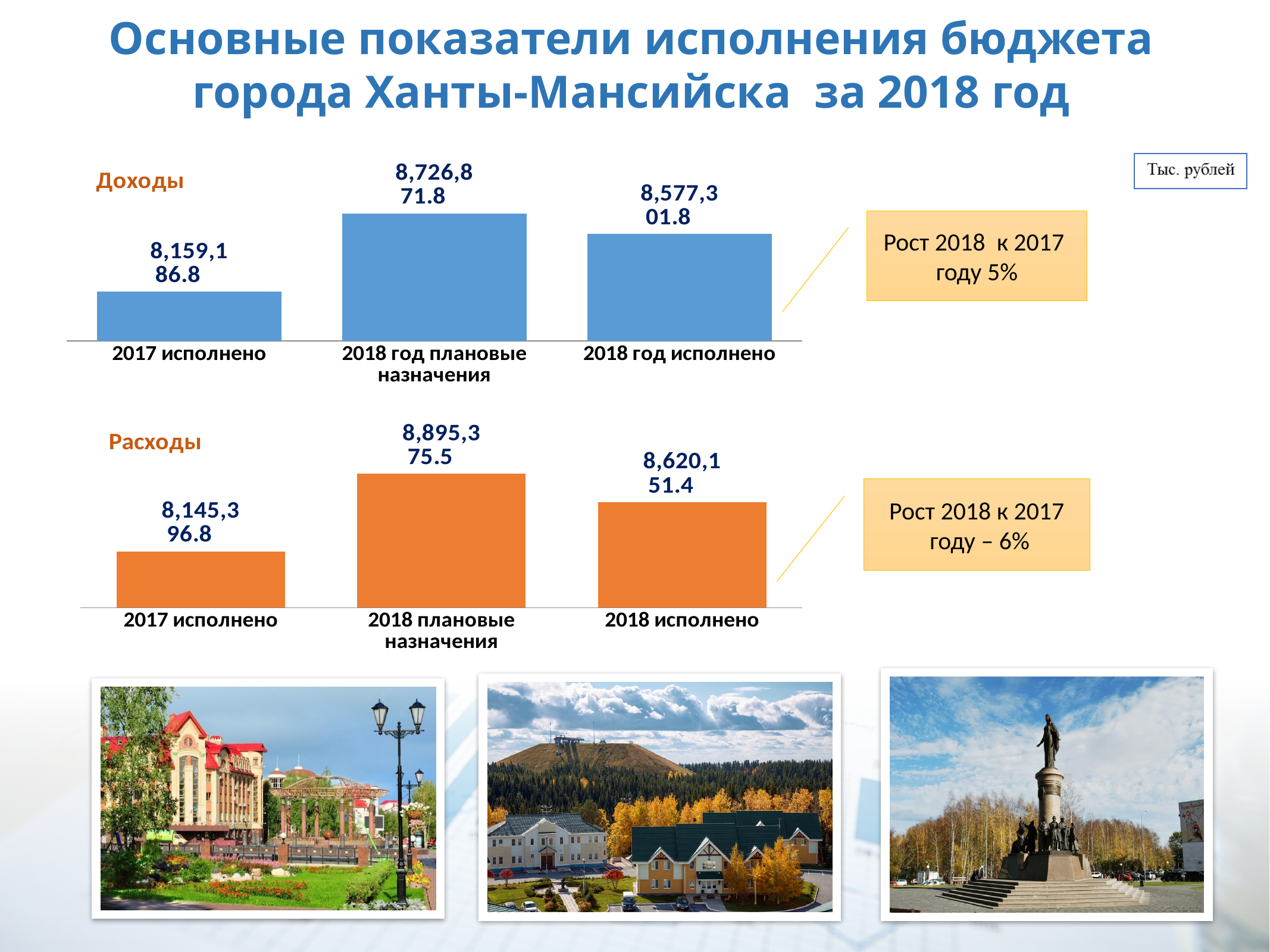
On the Расходы chart, which category has the lowest value? 2017 исполнено On the Расходы chart, what is the value for 2018 плановые назначения? 8,895,375.5 How many bars are on the Доходы chart? 3 On the Доходы chart, what is the value for 2018 год плановые назначения? 8,726,871.8 On the Расходы chart, which is larger: 2017 исполнено or 2018 исполнено? 2018 исполнено What type of chart is the Расходы chart? bar chart On the Доходы chart, what is the difference between 2018 год плановые назначения and 2018 год исполнено? 149,570.0 What unit of measurement is indicated for the charts on the slide? Тыс. рублей On the Расходы chart, what is the difference between 2018 плановые назначения and 2018 исполнено? 275,224.1 On the Расходы chart, what is the value for 2018 исполнено? 8,620,151.4 On the Доходы chart, what is the value for 2017 исполнено? 8,159,186.8 On the Доходы chart, which category has the highest value? 2018 год плановые назначения